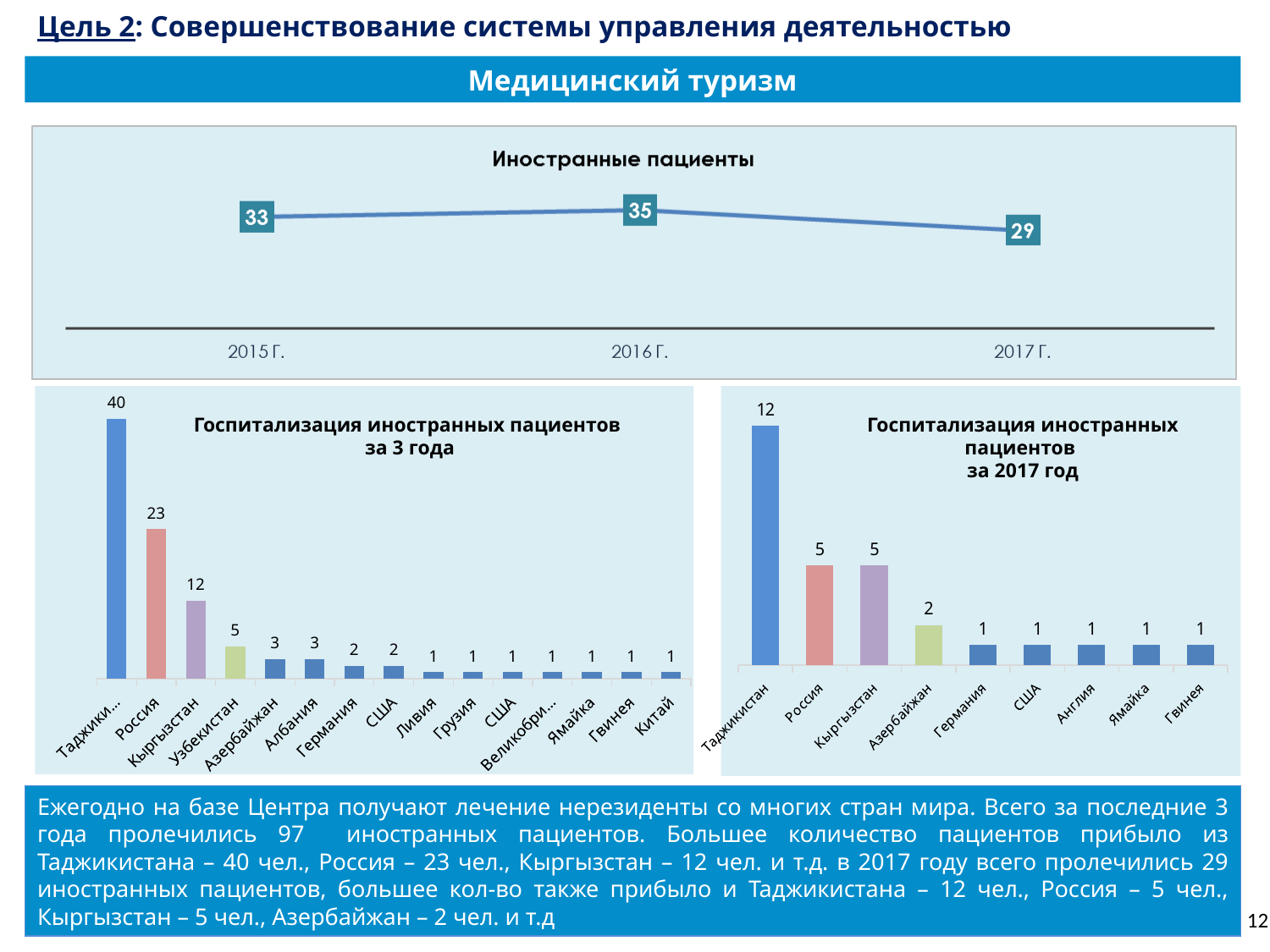
In the chart 'Госпитализация иностранных пациентов за 3 года', what is the value for Россия? 23 In the chart 'Госпитализация иностранных пациентов за 3 года', which is larger, Кыргызстан or Узбекистан? Кыргызстан In the chart 'Госпитализация иностранных пациентов за 2017 год', which category has the highest value? Таджикистан In the chart 'Госпитализация иностранных пациентов за 3 года', how many categories are plotted? 15 In the chart 'Иностранные пациенты', which year has the lowest value? 2017 г. What kind of chart is 'Иностранные пациенты'? line chart In the chart 'Иностранные пациенты', what is the value for 2016 г.? 35 In the chart 'Иностранные пациенты', what is the difference between the values for 2016 г. and 2017 г.? 6 In the chart 'Госпитализация иностранных пациентов за 2017 год', what is the value for Азербайжан? 2 In the chart 'Госпитализация иностранных пациентов за 2017 год', how many categories are plotted? 9 In the chart 'Госпитализация иностранных пациентов за 3 года', what is the difference between Россия and Кыргызстан? 11 What kind of chart is 'Госпитализация иностранных пациентов за 2017 год'? bar chart